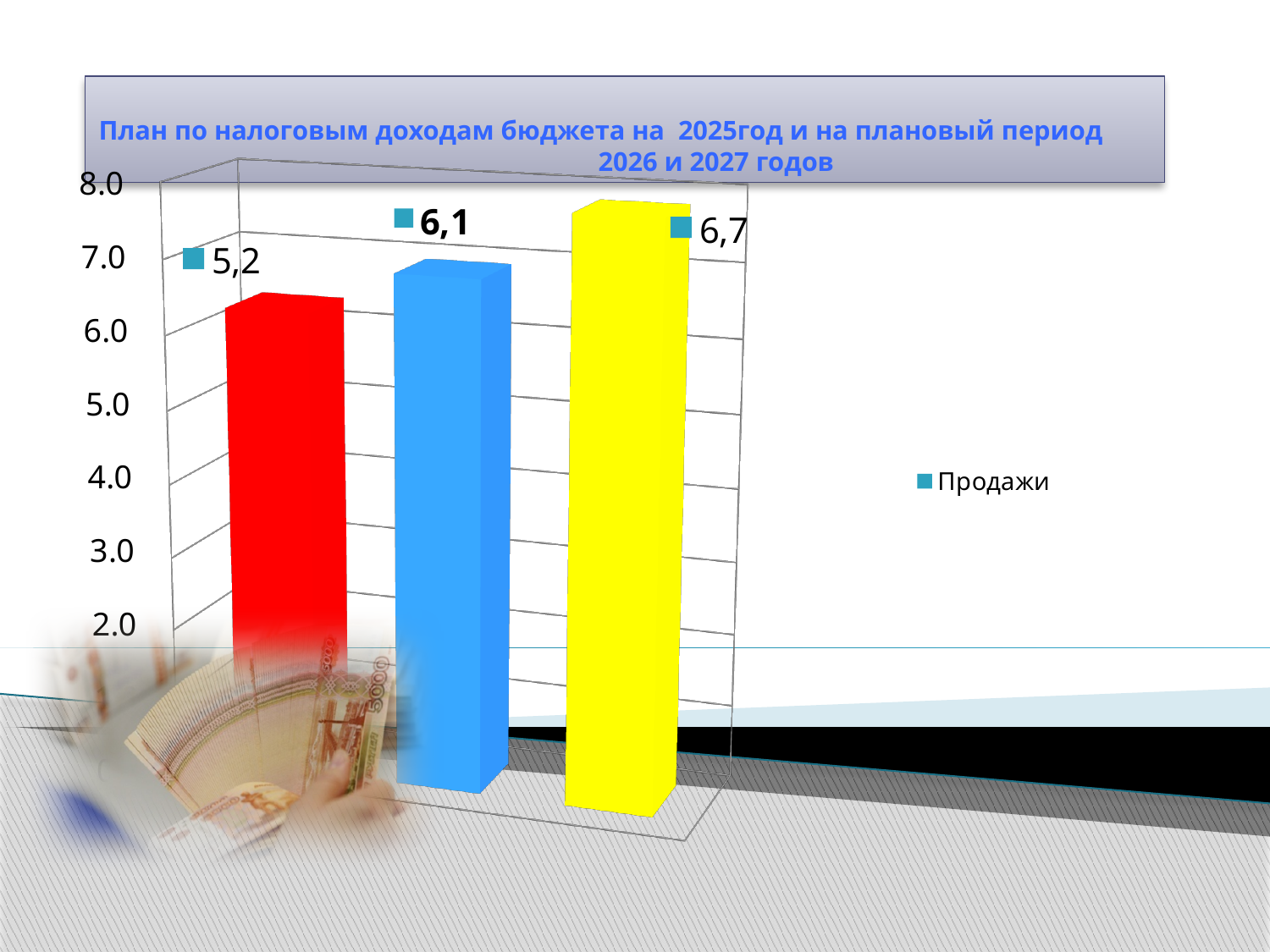
Which bar has the highest value? the yellow bar What is the difference between the yellow bar's value and the red bar's value? 1,5 How many bars are plotted in the chart? 3 Which bar has the lowest value? the red bar Which is larger, the value of the blue bar or the value of the yellow bar? the yellow bar What kind of chart is shown on the slide? bar chart What is the data label on the blue bar? 6,1 Do the bar values rise or fall from left to right? rise What is the data label on the red bar? 5,2 How many series does the legend list? 1 What is the data label on the yellow bar? 6,7